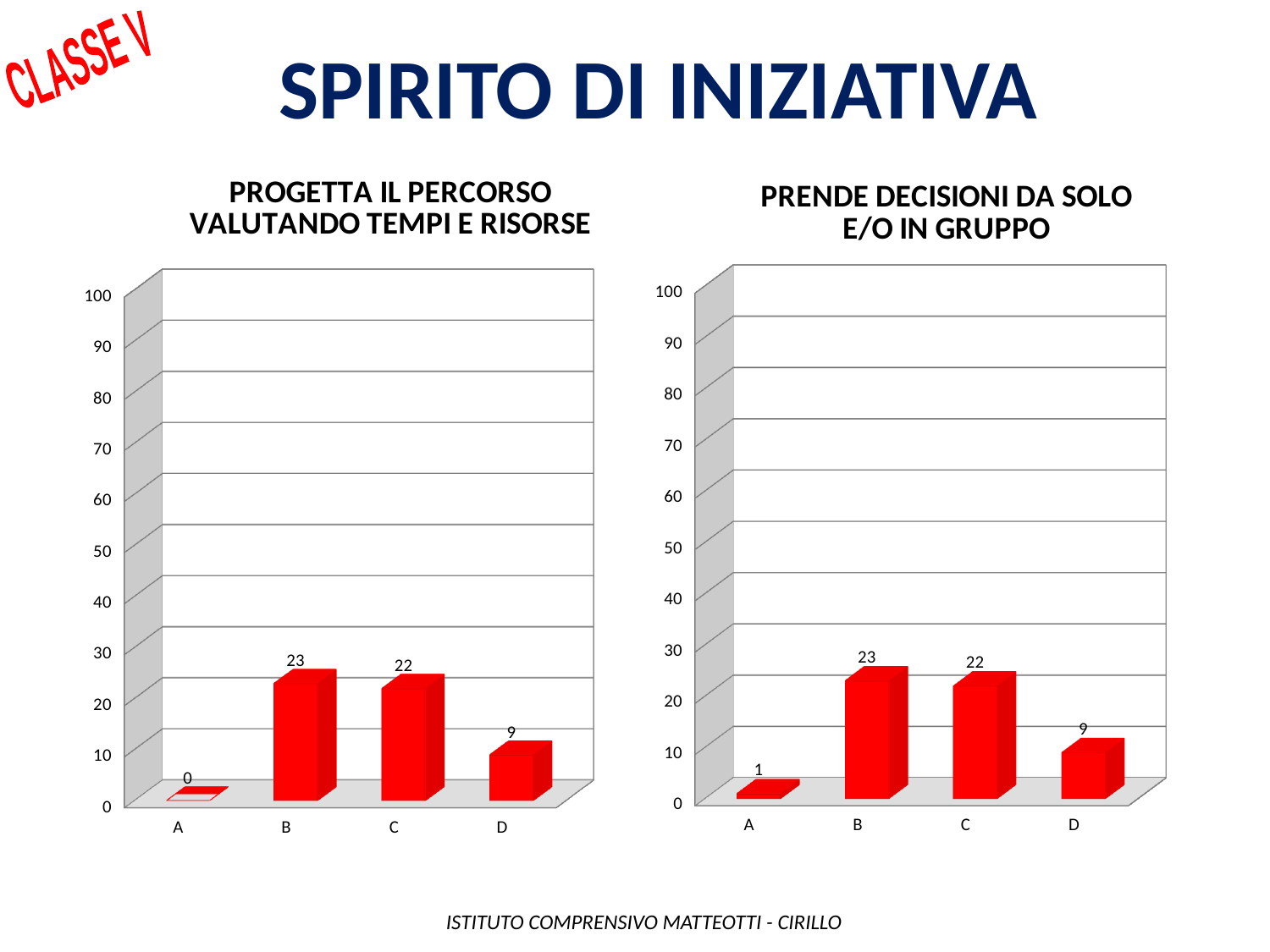
In the chart 'PROGETTA IL PERCORSO VALUTANDO TEMPI E RISORSE', is the value for B greater or less than 20? greater In the chart 'PROGETTA IL PERCORSO VALUTANDO TEMPI E RISORSE', what is the value for category A? 0 In the chart 'PRENDE DECISIONI DA SOLO E/O IN GRUPPO', which category has the lowest value? A In the chart 'PRENDE DECISIONI DA SOLO E/O IN GRUPPO', what is the value for category A? 1 In the chart 'PRENDE DECISIONI DA SOLO E/O IN GRUPPO', which is larger, the value for C or the value for D? C In the chart 'PRENDE DECISIONI DA SOLO E/O IN GRUPPO', what is the value for category D? 9 How many categories are shown in the chart 'PRENDE DECISIONI DA SOLO E/O IN GRUPPO'? 4 In the chart 'PRENDE DECISIONI DA SOLO E/O IN GRUPPO', what is the difference between the values for B and A? 22 In the chart 'PROGETTA IL PERCORSO VALUTANDO TEMPI E RISORSE', what is the difference between the values for C and D? 13 In the chart 'PROGETTA IL PERCORSO VALUTANDO TEMPI E RISORSE', what is the value for category B? 23 What kind of chart is 'PROGETTA IL PERCORSO VALUTANDO TEMPI E RISORSE'? bar chart In the chart 'PROGETTA IL PERCORSO VALUTANDO TEMPI E RISORSE', which category has the highest value? B